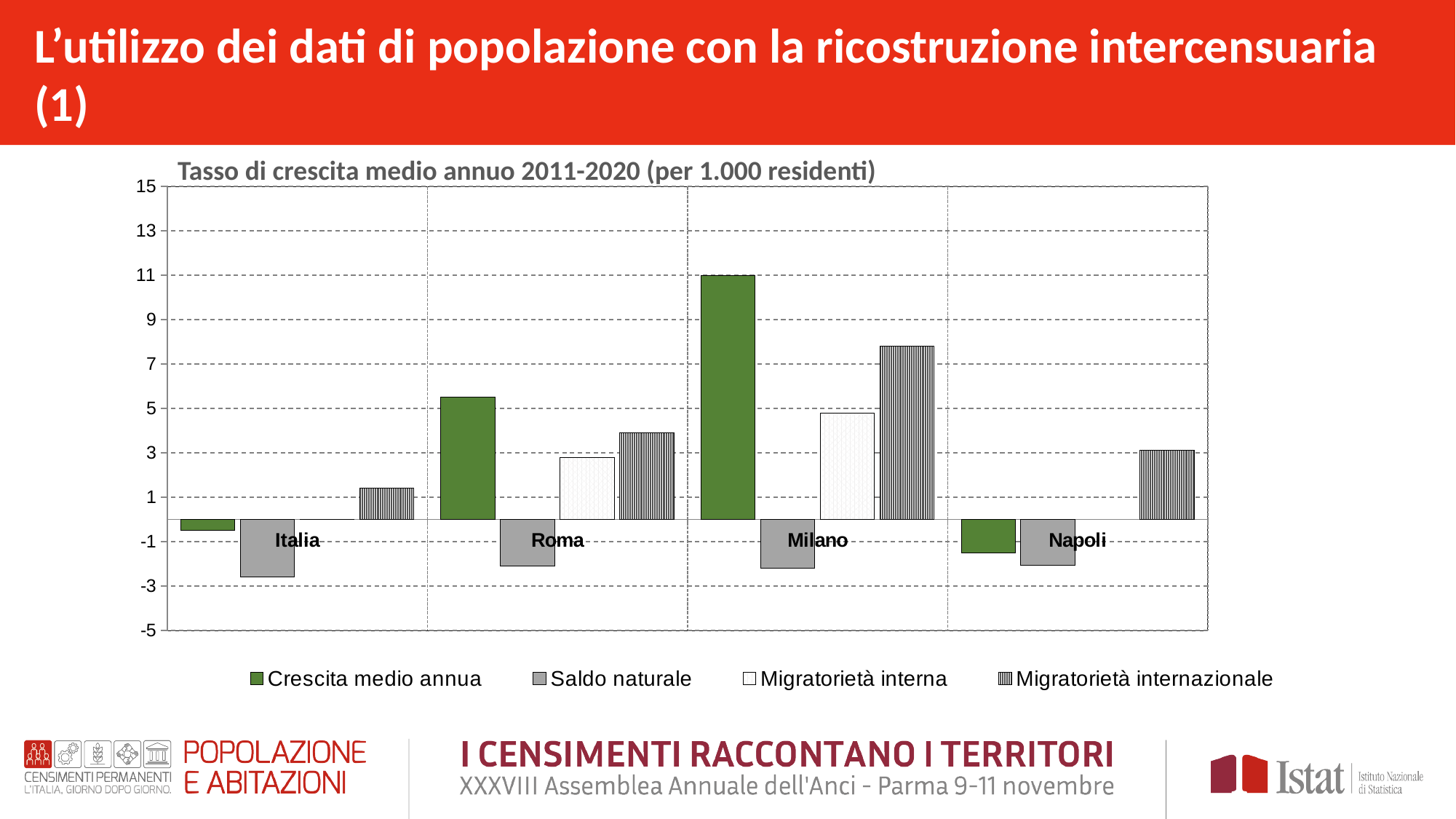
What kind of chart is shown on the slide? bar chart Is the value for Migratorietà internazionale in Milano greater or less than 7? greater Which category has the lowest value for Saldo naturale? Italia How many territorial categories are shown on the x axis of the chart? 4 What is the title of the chart? Tasso di crescita medio annuo 2011-2020 (per 1.000 residenti) Is the value for Crescita medio annua in Roma greater or less than 5? greater Which category has the highest value for Crescita medio annua? Milano Which category has the highest value for Migratorietà internazionale? Milano Which is larger, the Migratorietà internazionale value for Italia or for Napoli? Napoli How many series does the chart legend list? 4 Which is larger, the Migratorietà interna value for Roma or for Milano? Milano Is the value for Crescita medio annua in Napoli greater or less than -1? less